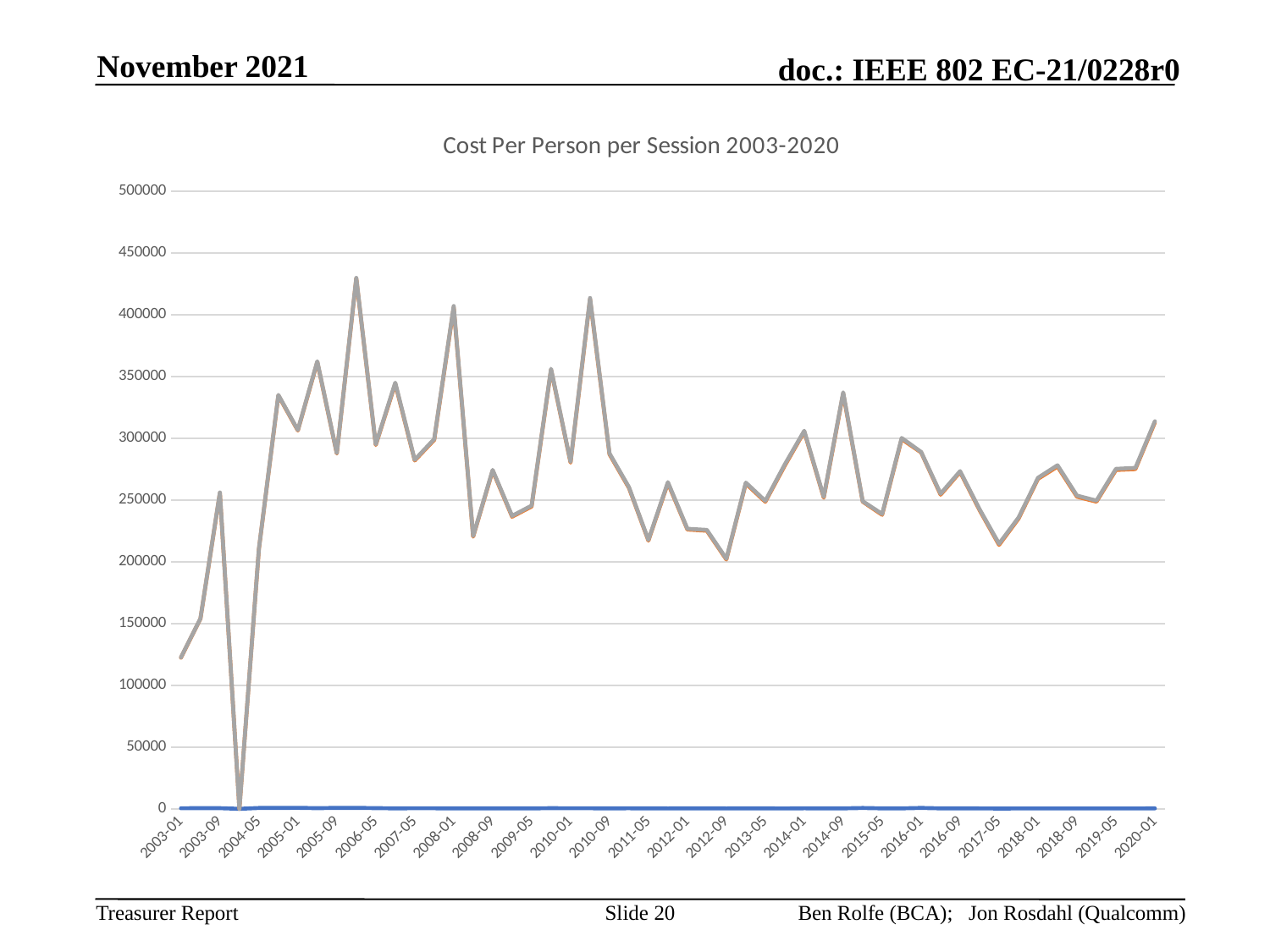
Is the highest point on the line greater or less than 400000? greater Is the value for 2017-05 greater or less than 250000? less Is the value for 2012-09 greater or less than 250000? less What is the highest value shown on the vertical axis? 500000 What is the title of the chart? Cost Per Person per Session 2003-2020 Does the line rise or fall between 2003-01 and 2003-09? rise Which is larger, the value for 2003-01 or the value for 2020-01? 2020-01 What kind of chart is shown on the slide? line chart